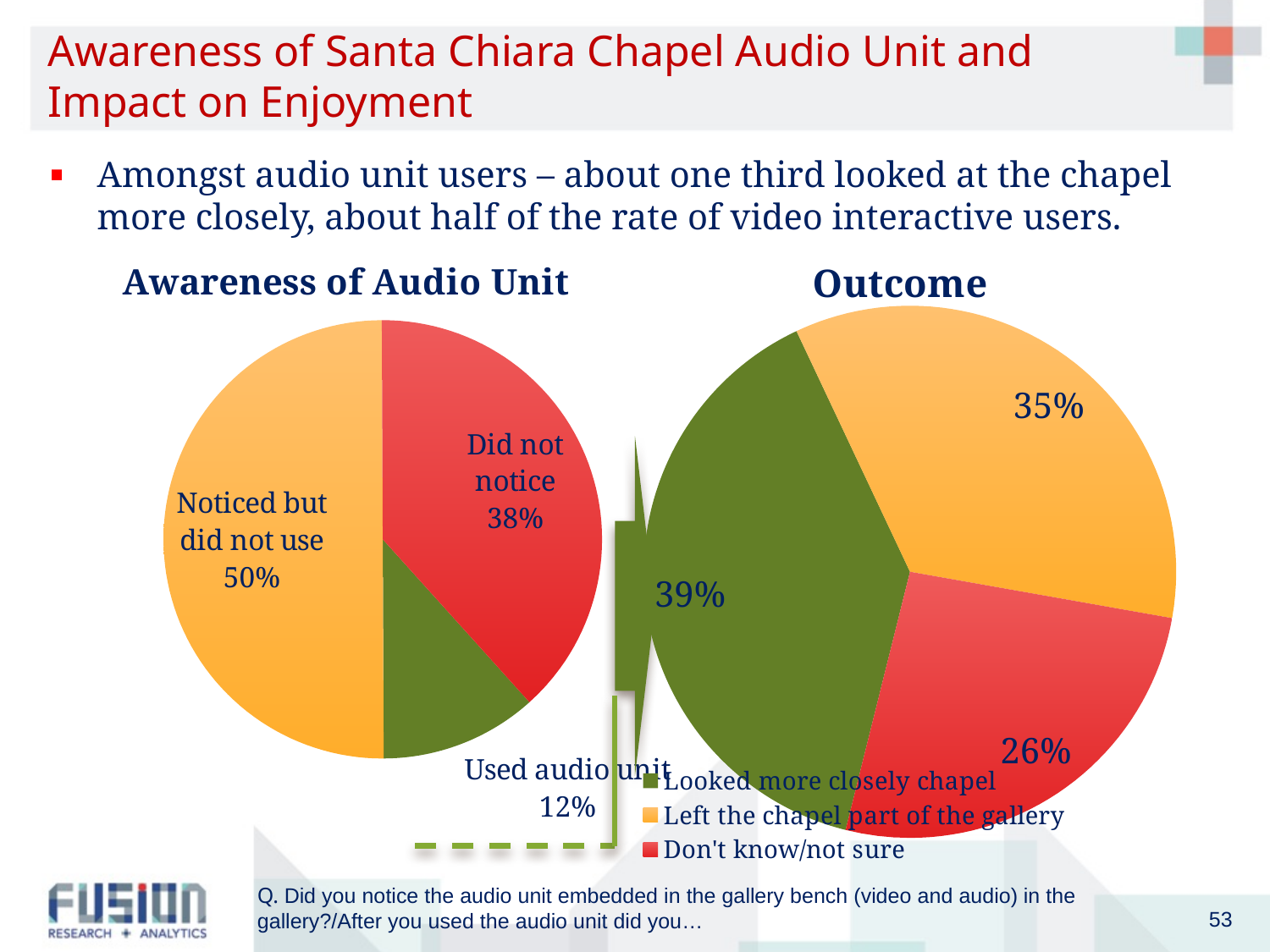
In the Outcome pie chart, what percentage looked more closely at the chapel? 39% In the Awareness of Audio Unit pie chart, what is the difference between the 'Noticed but did not use' share and the 'Did not notice' share? 12% In the Outcome pie chart, what percentage answered 'Don't know/not sure'? 26% In the Awareness of Audio Unit pie chart, what percentage did not notice the audio unit? 38% What type of chart is used for the Awareness of Audio Unit chart? Pie chart In the Awareness of Audio Unit pie chart, which category has the largest share? Noticed but did not use How many entries does the legend of the Outcome pie chart list? 3 In the Outcome pie chart, which is larger: 'Looked more closely chapel' or 'Don't know/not sure'? Looked more closely chapel In the Awareness of Audio Unit pie chart, which category has the smallest share? Used audio unit In the Awareness of Audio Unit pie chart, what share of respondents noticed but did not use the audio unit? 50% In the Outcome pie chart, what percentage left the chapel part of the gallery? 35% In the Awareness of Audio Unit pie chart, what percentage used the audio unit? 12%